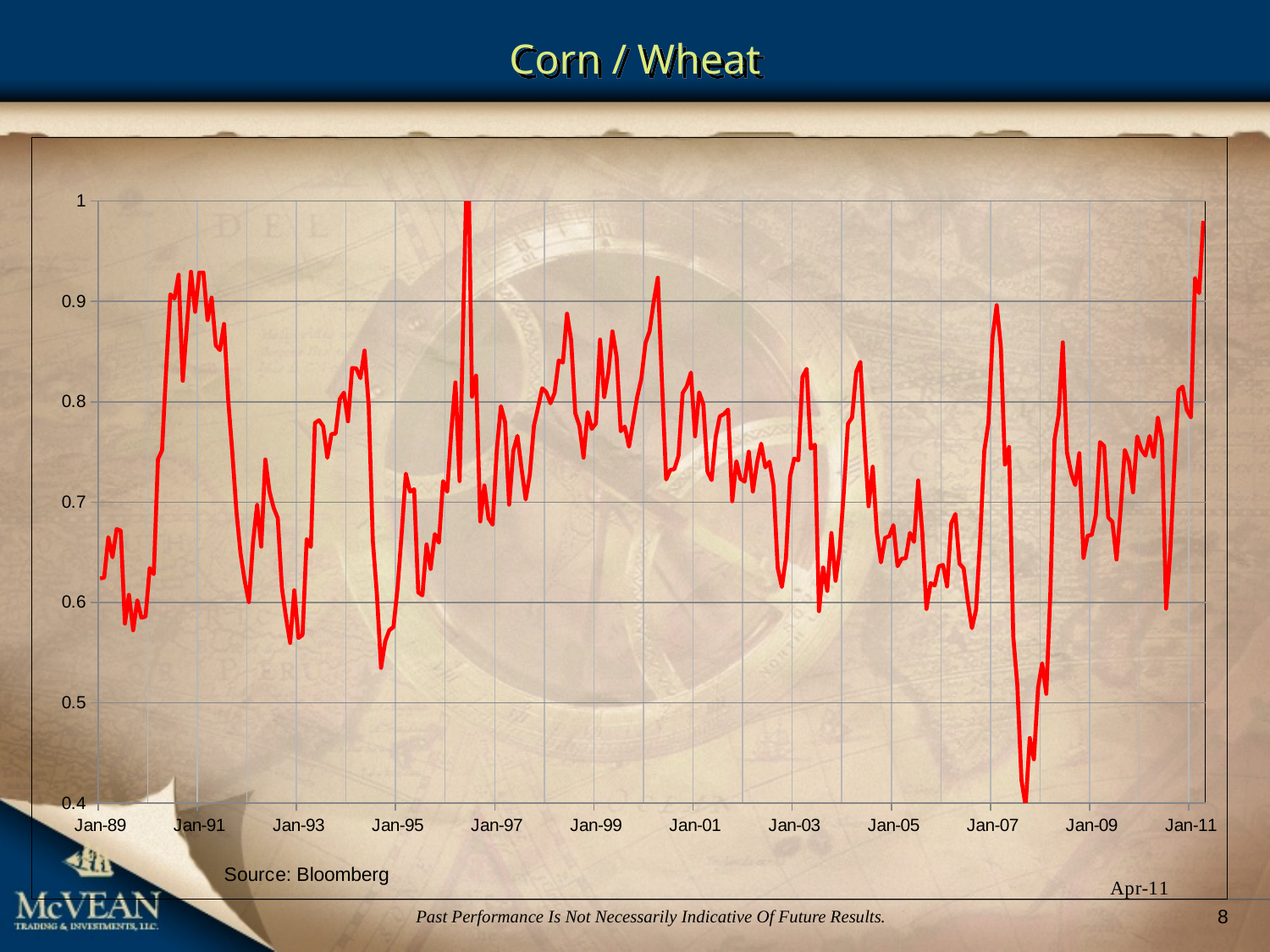
What is the title of the chart? Corn / Wheat Does the line generally rise or fall between Jan-09 and Jan-11? rise Is the value at Jan-91 greater or less than 0.9? greater What source is cited for the chart data? Bloomberg Is the lowest point of the line, reached shortly after Jan-07, greater or less than 0.5? less How many date labels are shown on the x axis? 12 What kind of chart is shown on the slide? line chart Is the value at the end of the series, at Jan-11, greater or less than 0.9? greater Does the line rise or fall between Jan-91 and Jan-92? fall